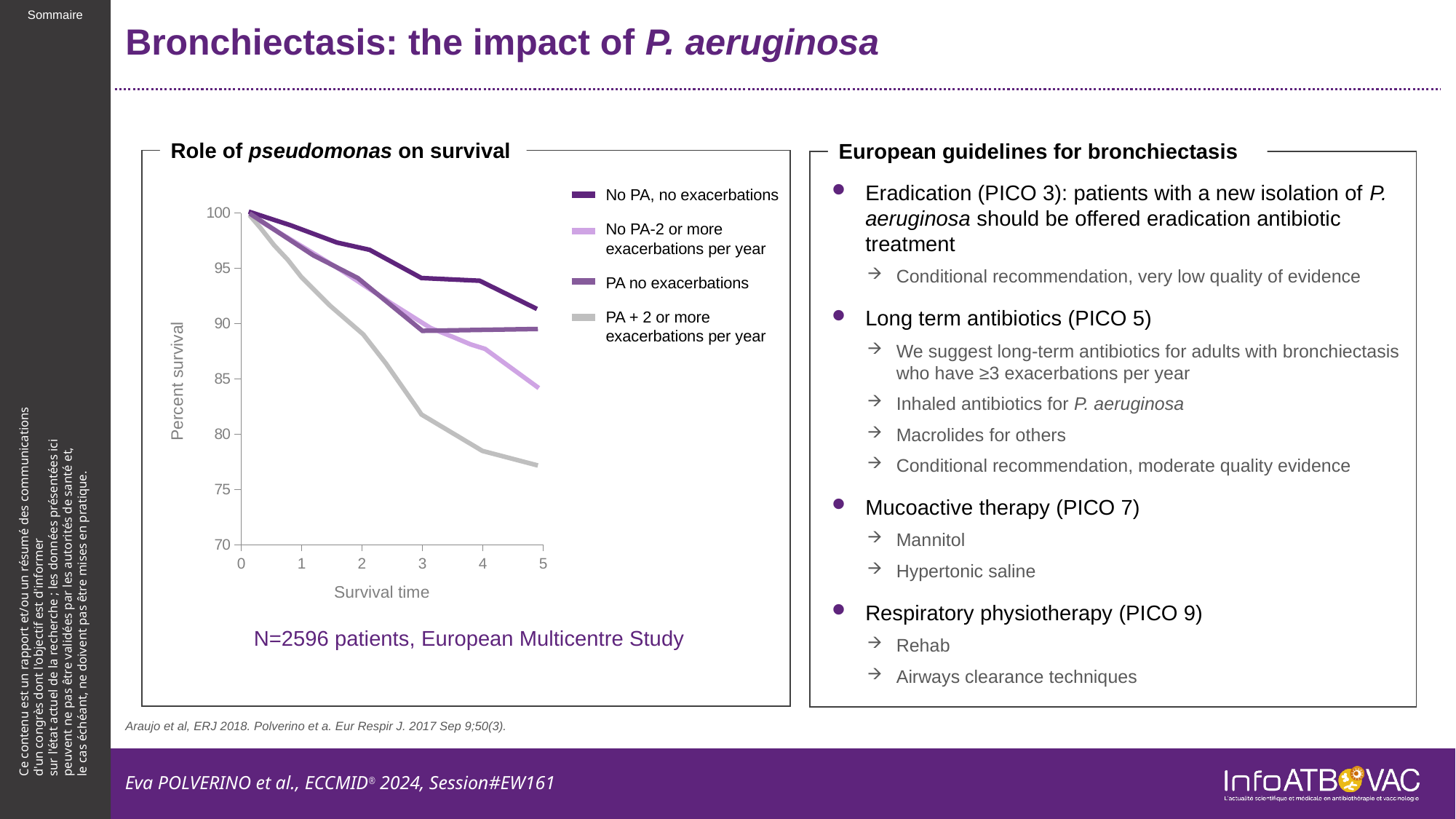
What is the label of the y axis of the survival chart? Percent survival Is the percent survival for "PA + 2 or more exacerbations per year" at survival time 5 greater or less than 80? less Do the percent survival values rise or fall as survival time increases? fall How many patients does the caption below the survival chart say were included? N=2596 patients What kind of chart is shown under "Role of pseudomonas on survival"? line chart What is the percent survival for all series at survival time 0? 100 Which series has the lowest percent survival at survival time 5? PA + 2 or more exacerbations per year Which series has the highest percent survival at survival time 5? No PA, no exacerbations Is the percent survival for "No PA-2 or more exacerbations per year" at survival time 5 greater or less than 85? less Is the percent survival for "No PA, no exacerbations" at survival time 5 greater or less than 90? greater Which series has higher percent survival at survival time 5: "PA no exacerbations" or "PA + 2 or more exacerbations per year"? PA no exacerbations How many series does the legend of the survival chart list? 4